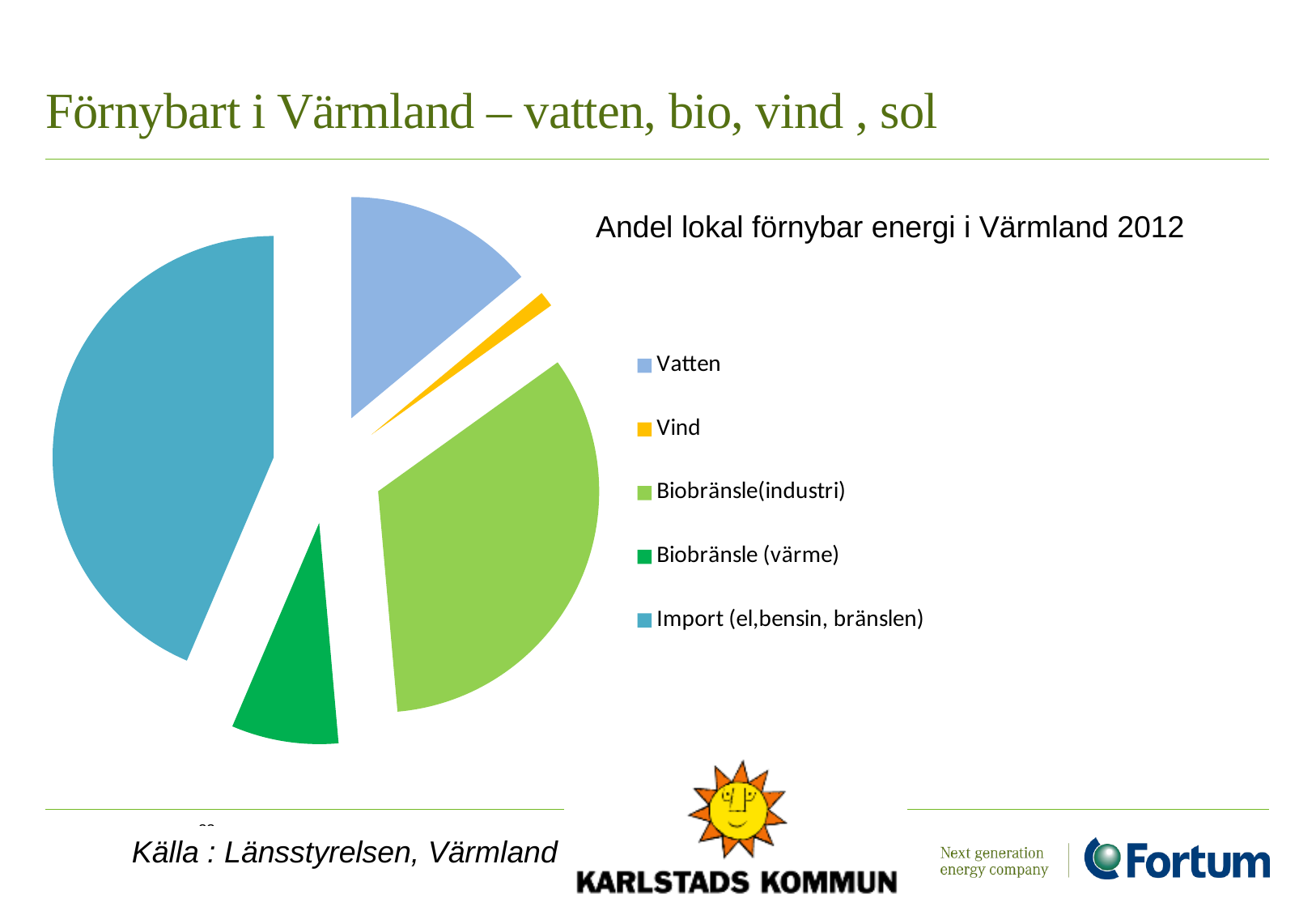
How many categories does the pie chart show? 5 Which category has the largest slice of the pie chart? Import (el,bensin, bränslen) Which slice is larger, Biobränsle(industri) or Vatten? Biobränsle(industri) Which slice is larger, Vatten or Vind? Vatten What kind of chart is shown on the slide? Pie chart What is the title of the pie chart? Andel lokal förnybar energi i Värmland 2012 Which slice is larger, Import (el,bensin, bränslen) or Vatten? Import (el,bensin, bränslen) Which category has the smallest slice of the pie chart? Vind What colour is the Vind slice in the pie chart? Yellow